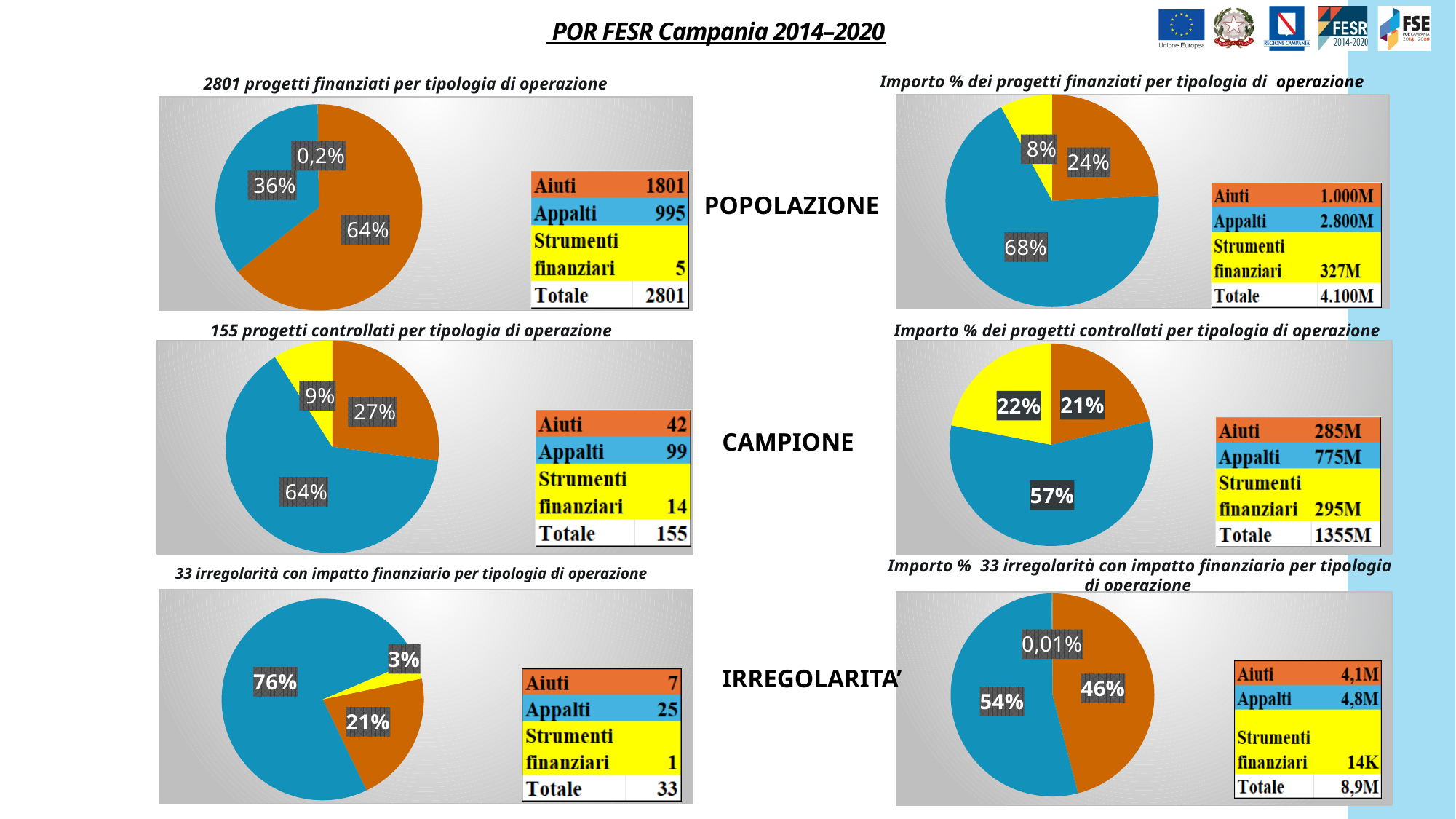
How many pie charts are shown on the slide? 6 What type of chart is used for '2801 progetti finanziati per tipologia di operazione'? Pie chart In the chart titled '2801 progetti finanziati per tipologia di operazione', what is the value shown for Appalti in the table? 995 In the chart titled '2801 progetti finanziati per tipologia di operazione', what share of the pie does Aiuti have? 64% In the chart titled 'Importo % dei progetti controllati per tipologia di operazione', what is the Totale value shown in the table? 1355M In the chart titled '33 irregolarità con impatto finanziario per tipologia di operazione', which category has the smallest slice? Strumenti finanziari In the chart titled 'Importo % dei progetti finanziati per tipologia di operazione', which category has the largest slice? Appalti In the chart titled 'Importo % dei progetti finanziati per tipologia di operazione', what share of the pie does Strumenti finanziari have? 8% In the chart titled 'Importo % dei progetti controllati per tipologia di operazione', what share of the pie does Appalti have? 57% In the chart titled '155 progetti controllati per tipologia di operazione', what is the difference between the Appalti and Aiuti values in the table? 57 In the chart titled 'Importo % 33 irregolarità con impatto finanziario per tipologia di operazione', which is larger, the Aiuti slice or the Appalti slice? Appalti In the chart titled '155 progetti controllati per tipologia di operazione', what is the value shown for Strumenti finanziari in the table? 14